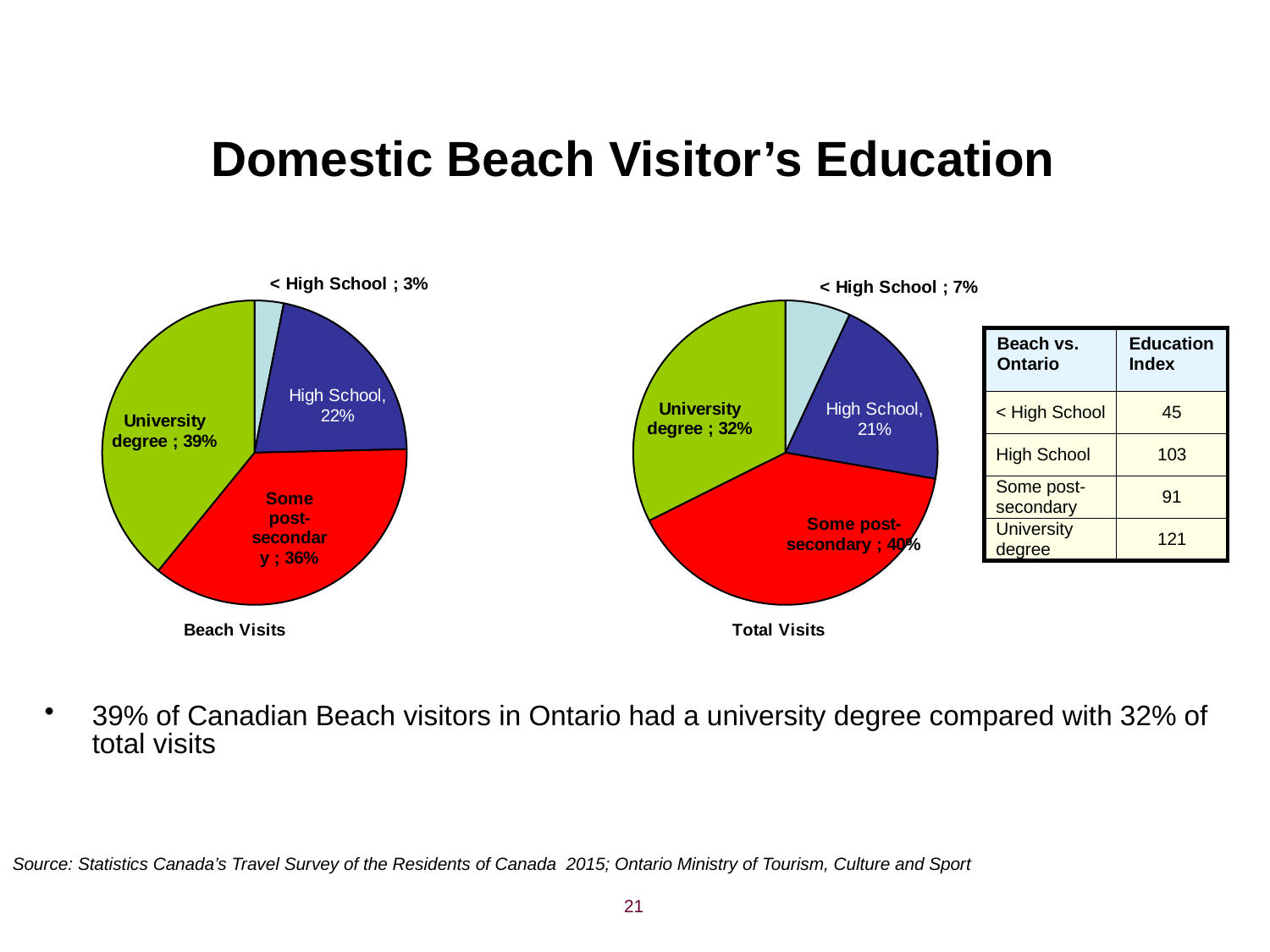
In the Beach Visits pie chart, what colour is the Some post-secondary slice? Red In the Beach Visits pie chart, what share of visitors had a university degree? 39% In the Beach Visits pie chart, which category has the largest share? University degree In the Total Visits pie chart, which category has the smallest share? < High School What type of chart is used for Beach Visits and Total Visits? Pie chart In the Beach Visits pie chart, what is the share for < High School? 3% In the Total Visits pie chart, what is the share for High School? 21% How many categories does the Beach Visits pie chart show? 4 Which is larger: the < High School share in the Beach Visits chart or in the Total Visits chart? Total Visits What is the difference between the University degree share in the Beach Visits chart and in the Total Visits chart? 7 percentage points In the Total Visits pie chart, what share is labelled Some post-secondary? 40% In the Total Visits pie chart, which category has the largest share? Some post-secondary